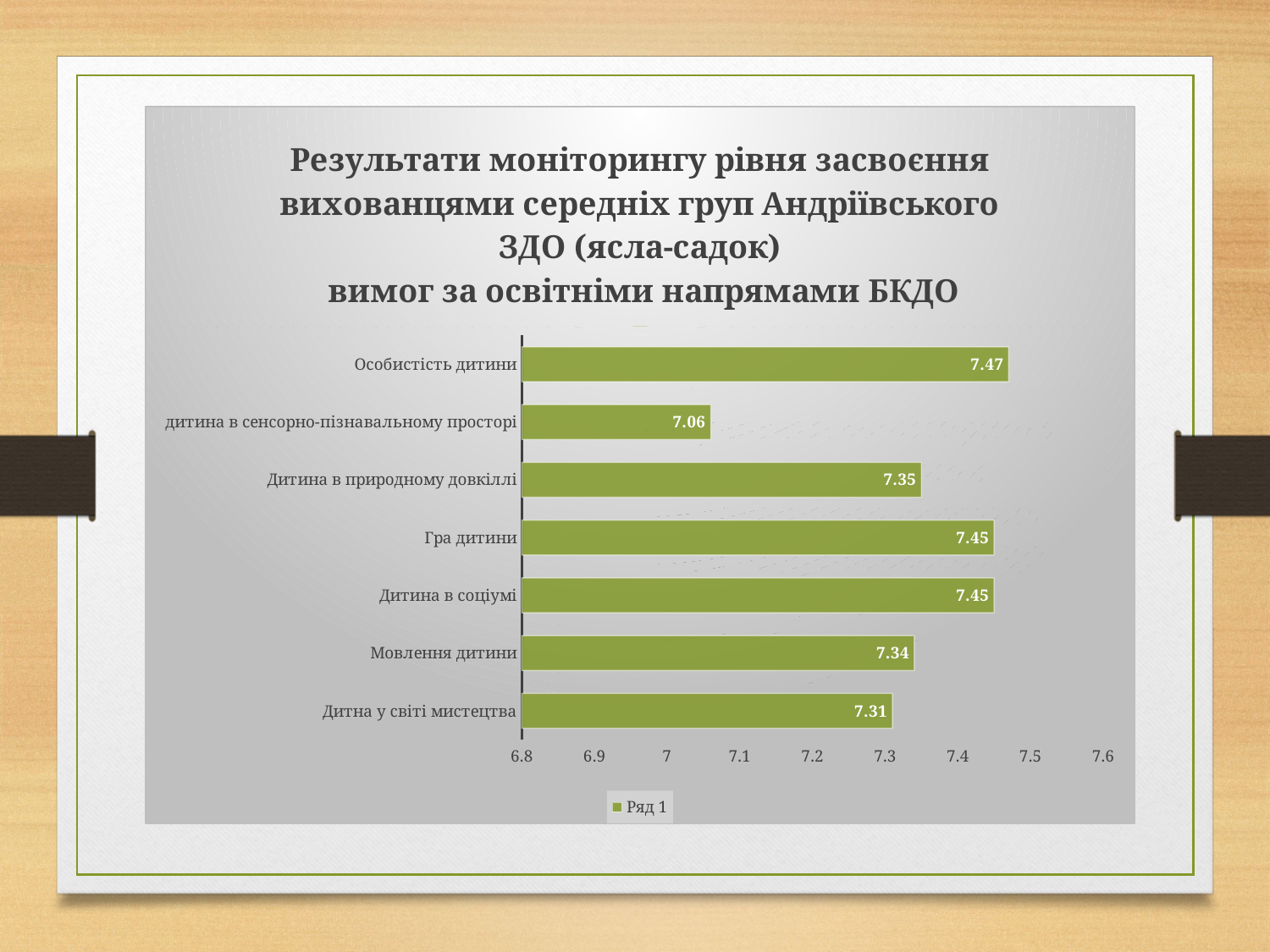
What is the value for дитина в сенсорно-пізнавальному просторі? 7.06 What kind of chart is shown on the slide? bar chart What is the difference between the values for Особистість дитини and дитина в сенсорно-пізнавальному просторі? 0.41 Which is larger, the value for Дитина в природному довкіллі or the value for Дитна у світі мистецтва? Дитина в природному довкіллі Is the value for Гра дитини greater or less than 7.4? greater What is the value for Мовлення дитини? 7.34 How many series does the legend list? 1 Which category has the lowest value? дитина в сенсорно-пізнавальному просторі What is the name of the series in the legend? Ряд 1 Which category has the highest value? Особистість дитини How many categories are shown in the chart? 7 What is the value for Особистість дитини? 7.47